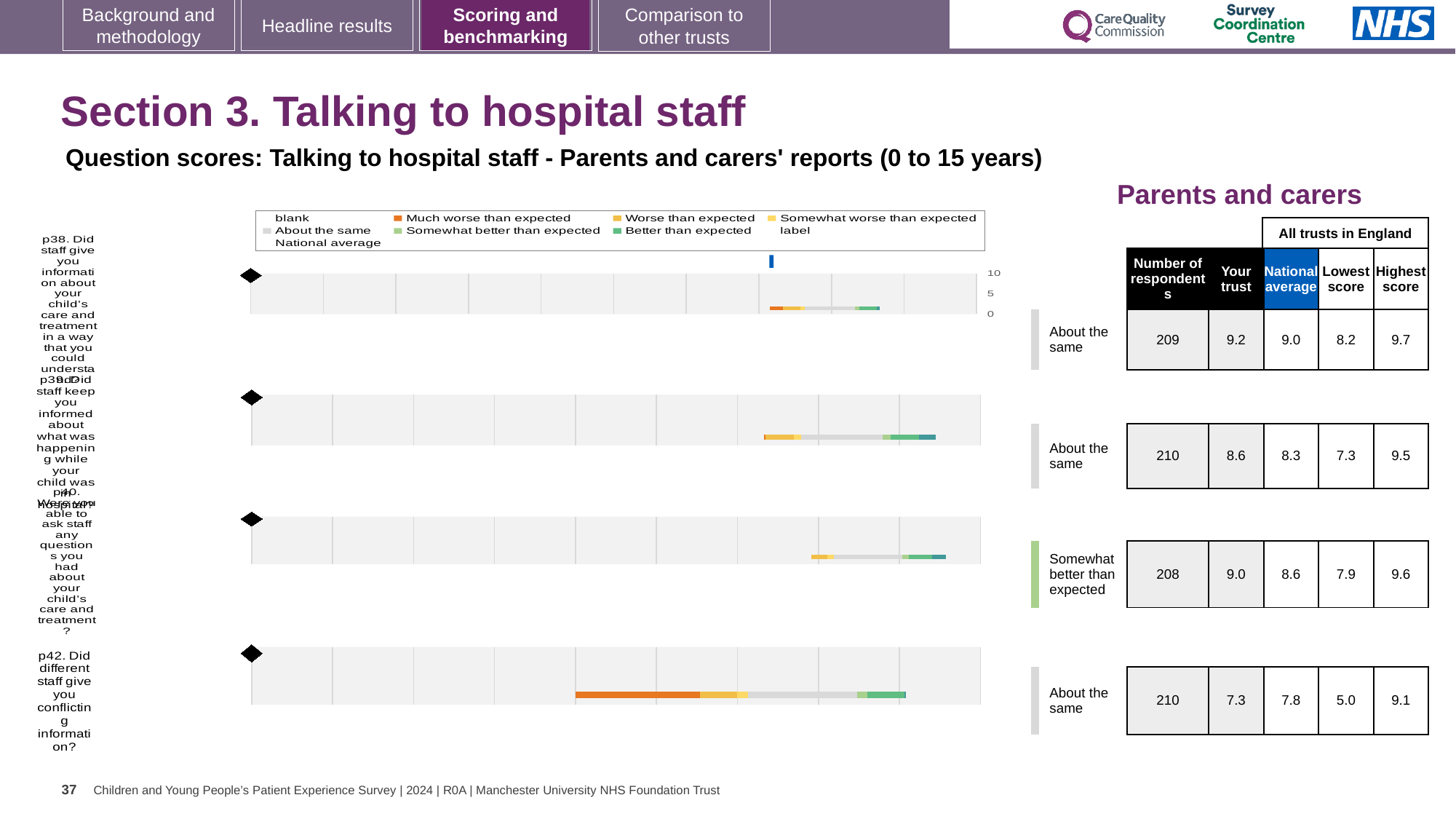
How many entries does the chart legend list? 9 What kind of chart is used for the question scores on this slide? bar chart In the table, what is the 'Your trust' score for p38 (information about your child's care and treatment)? 9.2 In the table, what is the National average for p42 (different staff giving conflicting information)? 7.8 In the table, what is the Lowest score for p39 (staff keeping you informed)? 7.3 Which benchmark category is shown for p40 (able to ask staff any questions)? Somewhat better than expected How many separate question charts are shown on the slide? 4 What is the difference between the 'Your trust' score and the National average for p40? 0.4 Which legend entry is shown in light grey? About the same Which question has the lowest 'Your trust' score in the table? p42 In the table, what is the Highest score for p40 (able to ask staff any questions)? 9.6 Which legend entry is shown in orange? Much worse than expected